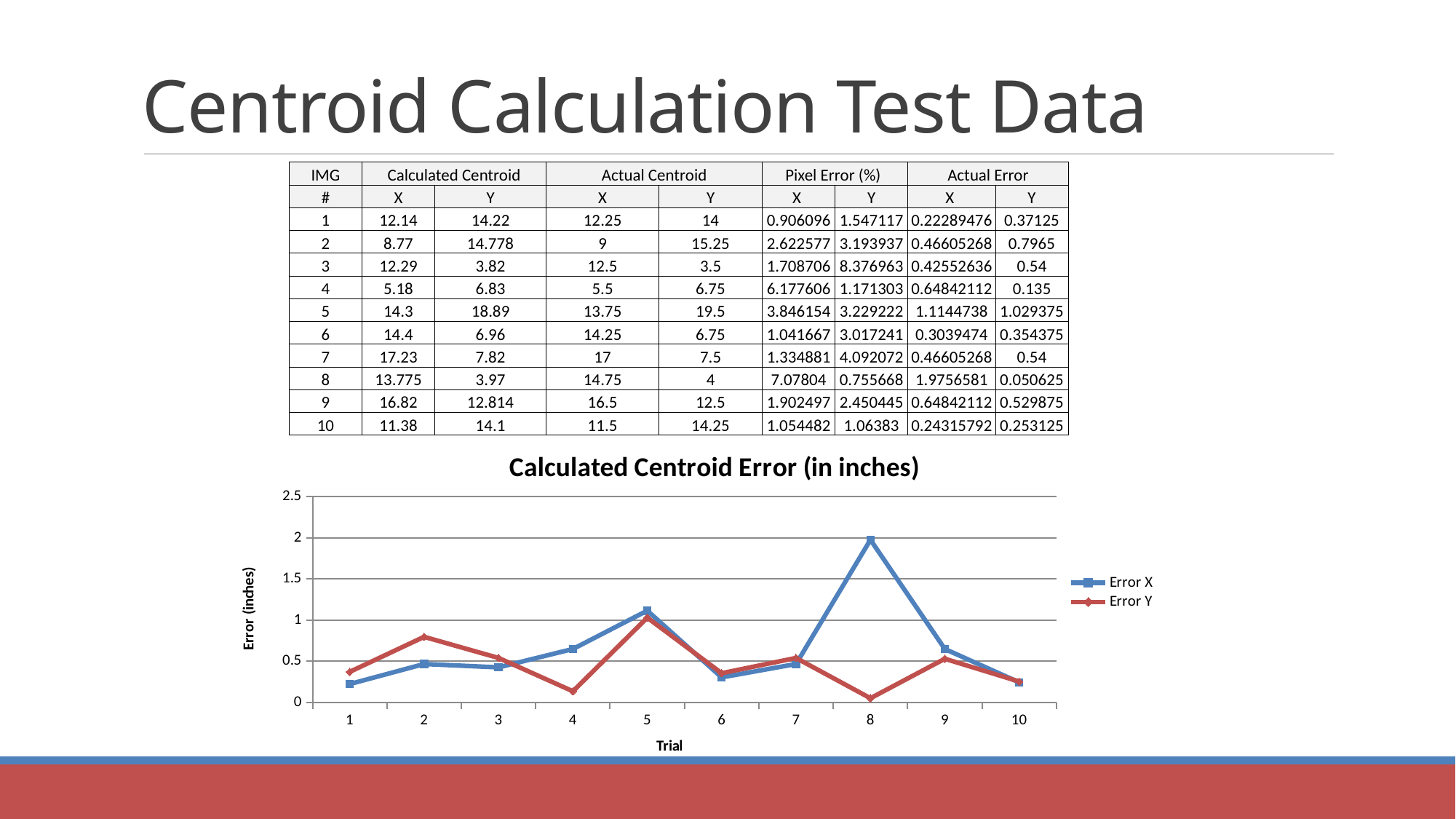
In the "Calculated Centroid Error (in inches)" chart, which series has the larger value at trial 2, Error X or Error Y? Error Y In the "Calculated Centroid Error (in inches)" chart, at which trial is Error Y highest? 5 In the "Calculated Centroid Error (in inches)" chart, at which trial is Error Y lowest? 8 What kind of chart is shown under the title "Calculated Centroid Error (in inches)"? line chart What is the y-axis title of the "Calculated Centroid Error (in inches)" chart? Error (inches) How many trials are plotted along the x axis of the "Calculated Centroid Error (in inches)" chart? 10 How many series does the legend of the "Calculated Centroid Error (in inches)" chart list? 2 In the "Calculated Centroid Error (in inches)" chart, at which trial is Error X highest? 8 In the "Calculated Centroid Error (in inches)" chart, is the Error X value at trial 8 greater or less than 1.5? greater In the "Calculated Centroid Error (in inches)" chart, which series has the larger value at trial 8, Error X or Error Y? Error X In the "Calculated Centroid Error (in inches)" chart, does Error X rise or fall from trial 8 to trial 10? fall In the "Calculated Centroid Error (in inches)" chart, is the Error Y value at trial 4 greater or less than 0.5? less